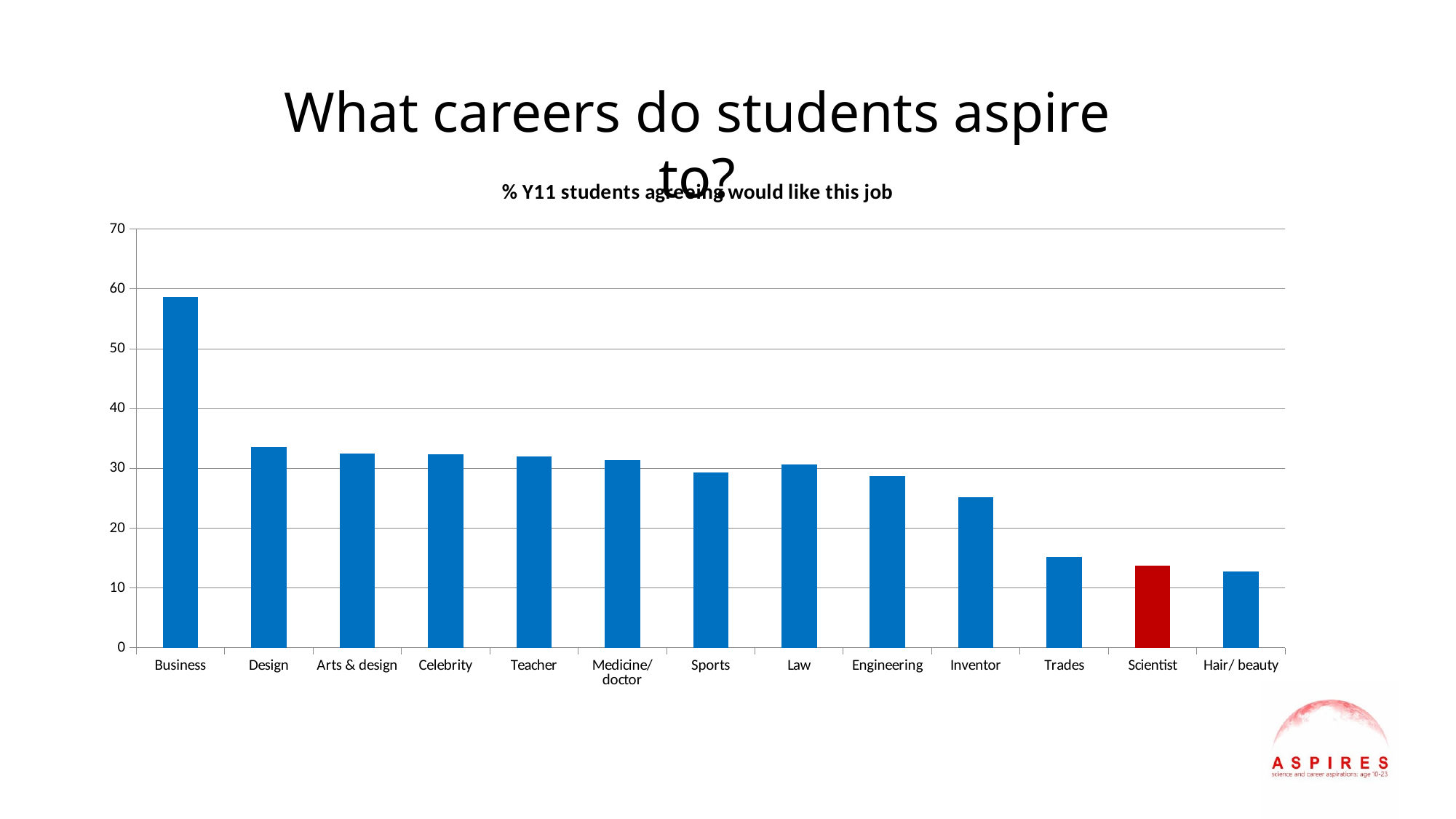
Is the value for Scientist greater or less than 20? less Is the value for Inventor greater or less than 20? greater Is the value for Business greater or less than 50? greater How many careers are shown on the x axis of the chart? 13 Which career's bar is coloured red rather than blue? Scientist What kind of chart is shown on the slide? bar chart Do the values generally rise or fall moving from left to right along the x axis? fall Which is larger, the value for Engineering or the value for Inventor? Engineering Which is larger, the value for Business or the value for Design? Business Which career has the highest percentage of Y11 students agreeing they would like the job? Business